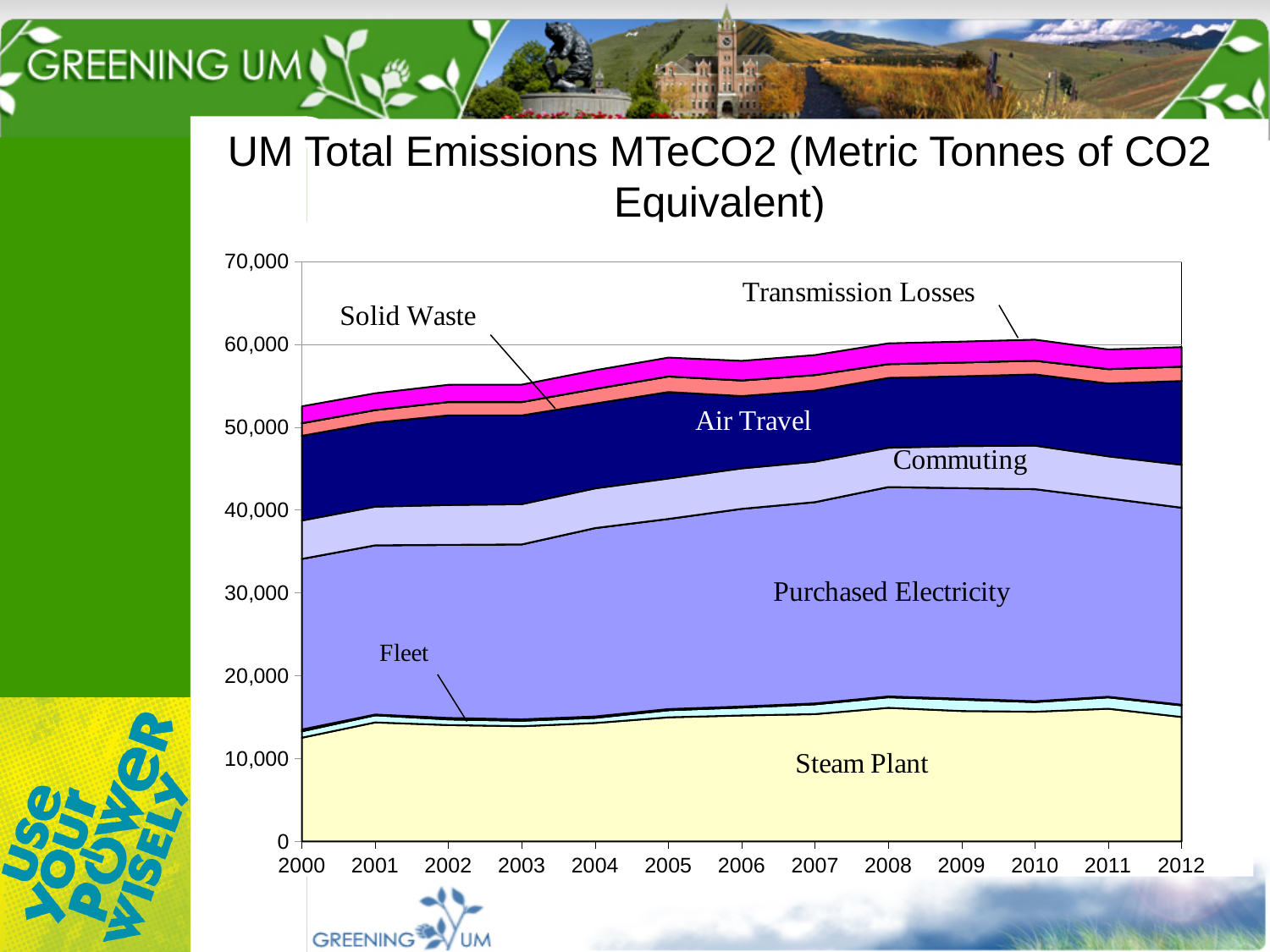
How many years are shown along the x axis of the chart? 13 What is the title of the chart? UM Total Emissions MTeCO2 (Metric Tonnes of CO2 Equivalent) What kind of chart is shown on the slide? Stacked area chart Is the total emissions value for 2005 greater or less than 50,000? greater Is the total emissions value for 2000 greater or less than 60,000? less Do total emissions generally rise or fall from 2000 to 2010? rise Which is larger in 2012, the Steam Plant area or the Commuting area? Steam Plant Which emission category occupies the largest area in the chart? Purchased Electricity Which emission category is plotted at the bottom of the stacked area chart? Steam Plant Is the Steam Plant emissions value for 2000 greater or less than 20,000? less How many emission categories are labelled in the chart? 7